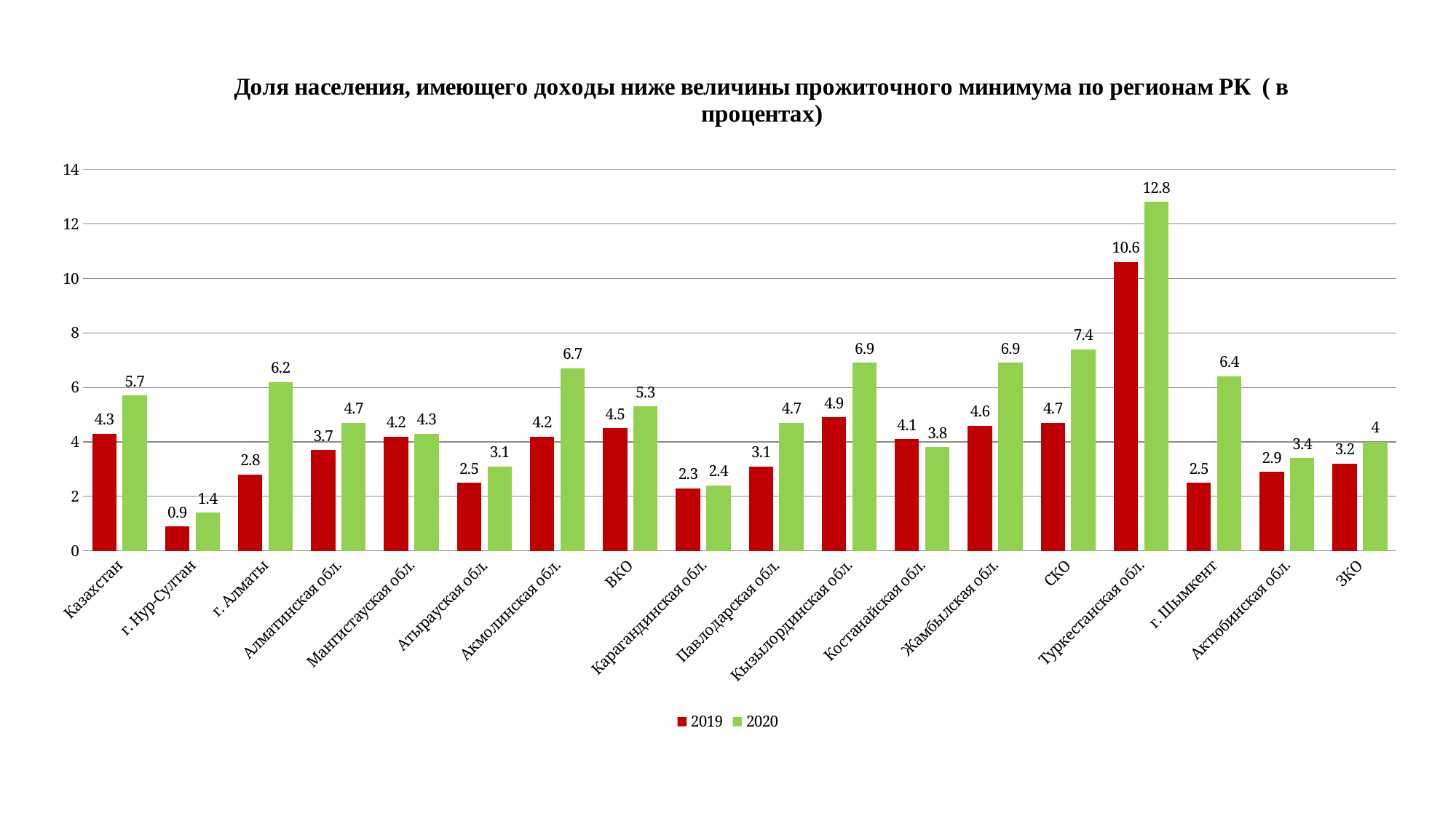
What is the 2020 value for Туркестанская обл.? 12.8 How many regions (categories) are shown on the x axis? 18 What is the 2020 value for г. Шымкент? 6.4 What is the 2019 value for г. Нур-Султан? 0.9 Is the 2020 value for СКО greater or less than 6? greater Which is larger for Костанайская обл., the 2019 value or the 2020 value? 2019 What is the difference between the 2020 and 2019 values for г. Алматы? 3.4 How many series does the legend list? 2 Which region has the highest 2019 value? Туркестанская обл. Which colour represents the 2020 series in the legend? green What type of chart is shown on the slide? bar chart Which region has the lowest 2020 value? г. Нур-Султан